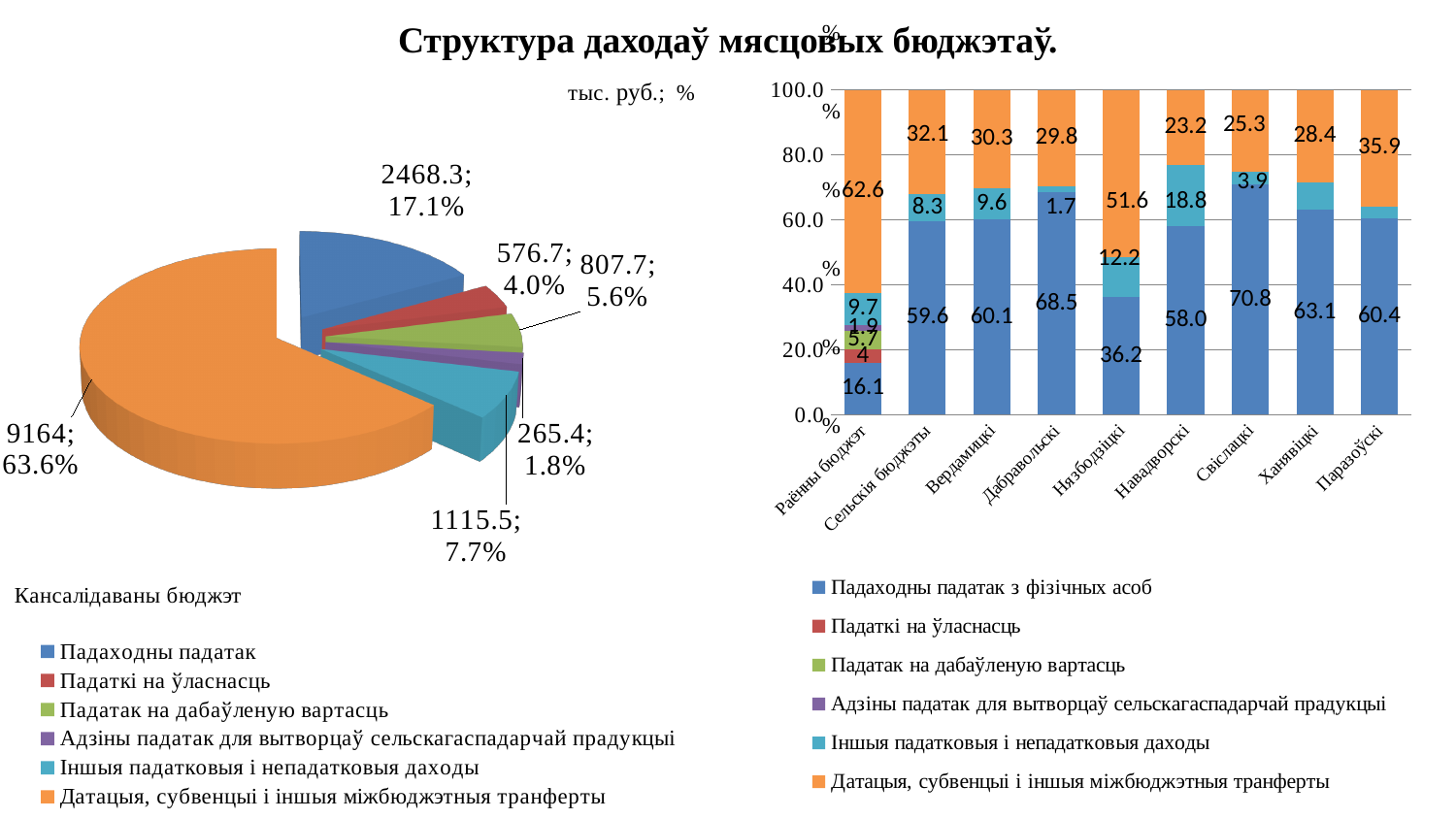
In the stacked bar chart on the right, what is the value of Датацыі, субвенцыі і іншыя міжбюджэтныя трансферты for Нязбодзіцкі? 51.6 In the pie chart on the left, how many slices are there? 6 In the stacked bar chart on the right, which is larger: the Падаходны падатак value for Дабравольскі or for Ханявіцкі? Дабравольскі In the stacked bar chart on the right, which category has the lowest value for Падаходны падатак з фізічных асоб? Раённы бюджэт In the pie chart on the left, what is the value shown for the largest slice (Датацыі, субвенцыі і іншыя міжбюджэтныя трансферты)? 9164; 63.6% In the stacked bar chart on the right, how many series does the legend list? 6 What type of chart is the chart on the left of the slide? Pie chart In the stacked bar chart on the right, how many categories are shown on the x axis? 9 In the pie chart on the left, which category has the smallest slice? Адзіны падатак для вытворцаў сельскагаспадарчай прадукцыі In the pie chart on the left, what share does the Падаходны падатак slice have? 17.1% In the stacked bar chart on the right, what is the value of Падаходны падатак з фізічных асоб for Свіслацкі? 70.8 In the stacked bar chart on the right, what is the difference between the Датацыі values for Паразоўскі and Навадворскі? 12.7